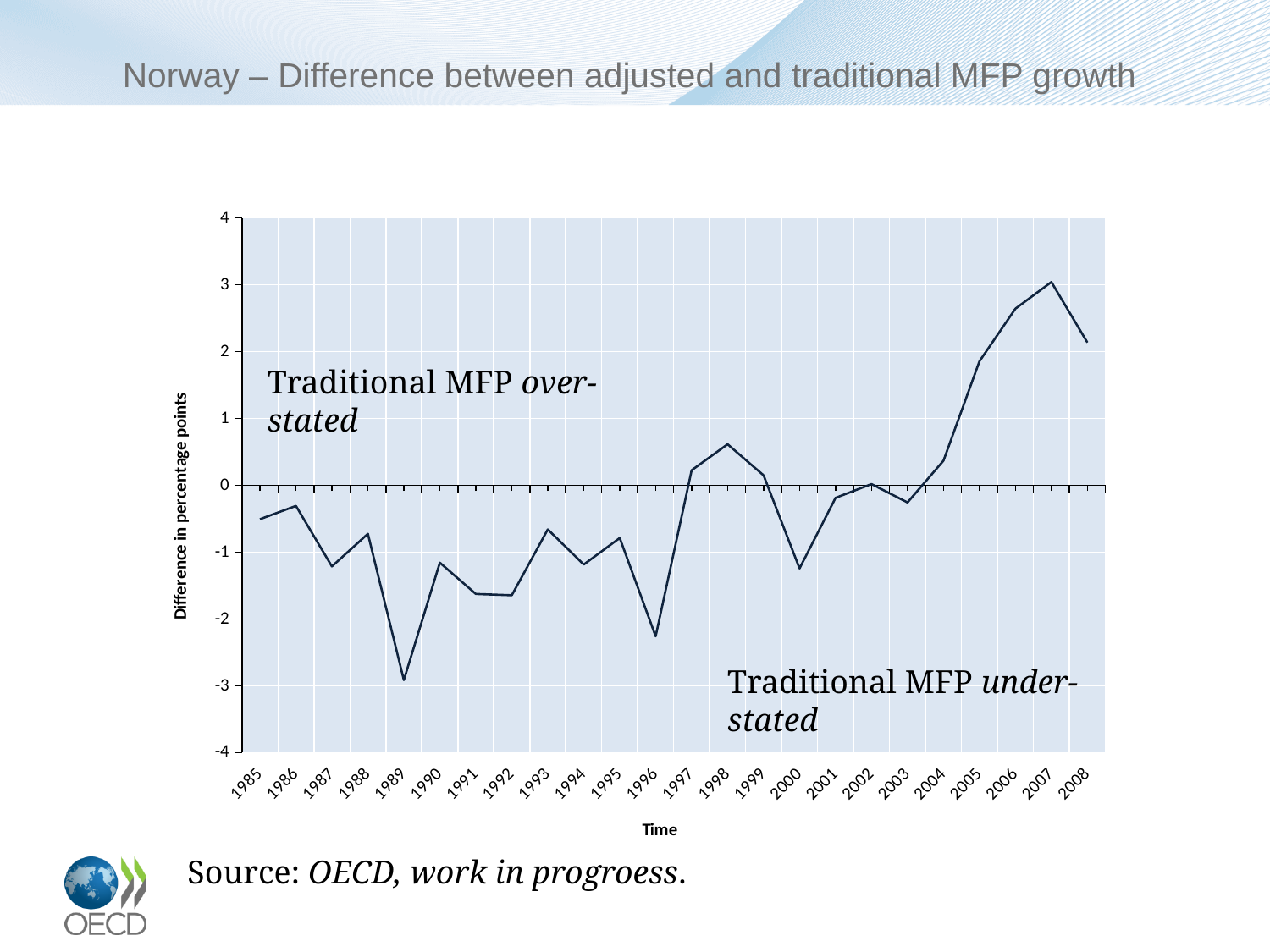
What kind of chart is shown on the slide? Line chart Is the value for 1996 greater or less than -2? less Is the value for 2000 greater or less than -1? less In which year is the difference between adjusted and traditional MFP growth lowest? 1989 Do the values rise or fall from 2003 to 2007? Rise Which year has the lower value, 1989 or 1996? 1989 How many years are plotted along the x axis? 24 What is the label on the y axis of the chart? Difference in percentage points Is the value for 2007 greater or less than 2? greater Which year has the larger value, 2006 or 2007? 2007 In which year is the difference between adjusted and traditional MFP growth highest? 2007